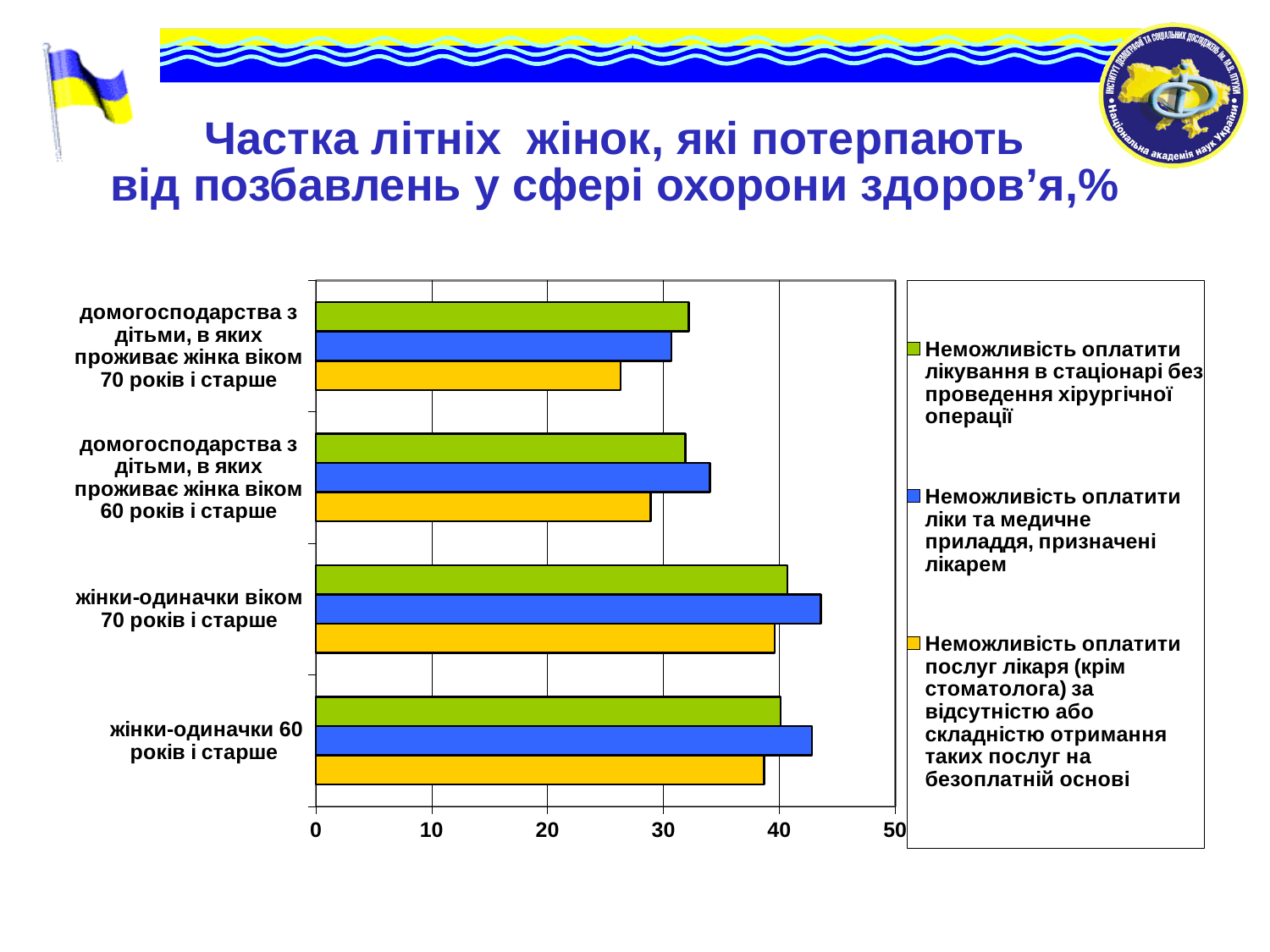
Is the value of 'Неможливість оплатити ліки та медичне приладдя' for 'жінки-одиначки віком 70 років і старше' greater or less than 40? greater Which category has the lowest value for 'Неможливість оплатити послуг лікаря'? домогосподарства з дітьми, в яких проживає жінка віком 70 років і старше Which colour represents 'Неможливість оплатити ліки та медичне приладдя, призначені лікарем' in the chart? blue How many categories (household types) are shown on the vertical axis of the chart? 4 Is the value of 'Неможливість оплатити лікування в стаціонарі' for 'домогосподарства з дітьми, в яких проживає жінка віком 60 років і старше' greater or less than 40? less For 'домогосподарства з дітьми, в яких проживає жінка віком 70 років і старше', which is larger: 'Неможливість оплатити лікування в стаціонарі' or 'Неможливість оплатити послуг лікаря'? Неможливість оплатити лікування в стаціонарі How many series does the chart's legend list? 3 Which category has the highest value for 'Неможливість оплатити ліки та медичне приладдя, призначені лікарем'? жінки-одиначки віком 70 років і старше For 'жінки-одиначки 60 років і старше', which is larger: 'Неможливість оплатити ліки та медичне приладдя' or 'Неможливість оплатити послуг лікаря'? Неможливість оплатити ліки та медичне приладдя What kind of chart is shown on the slide? bar chart Is the value of 'Неможливість оплатити послуг лікаря' for 'домогосподарства з дітьми, в яких проживає жінка віком 70 років і старше' greater or less than 30? less